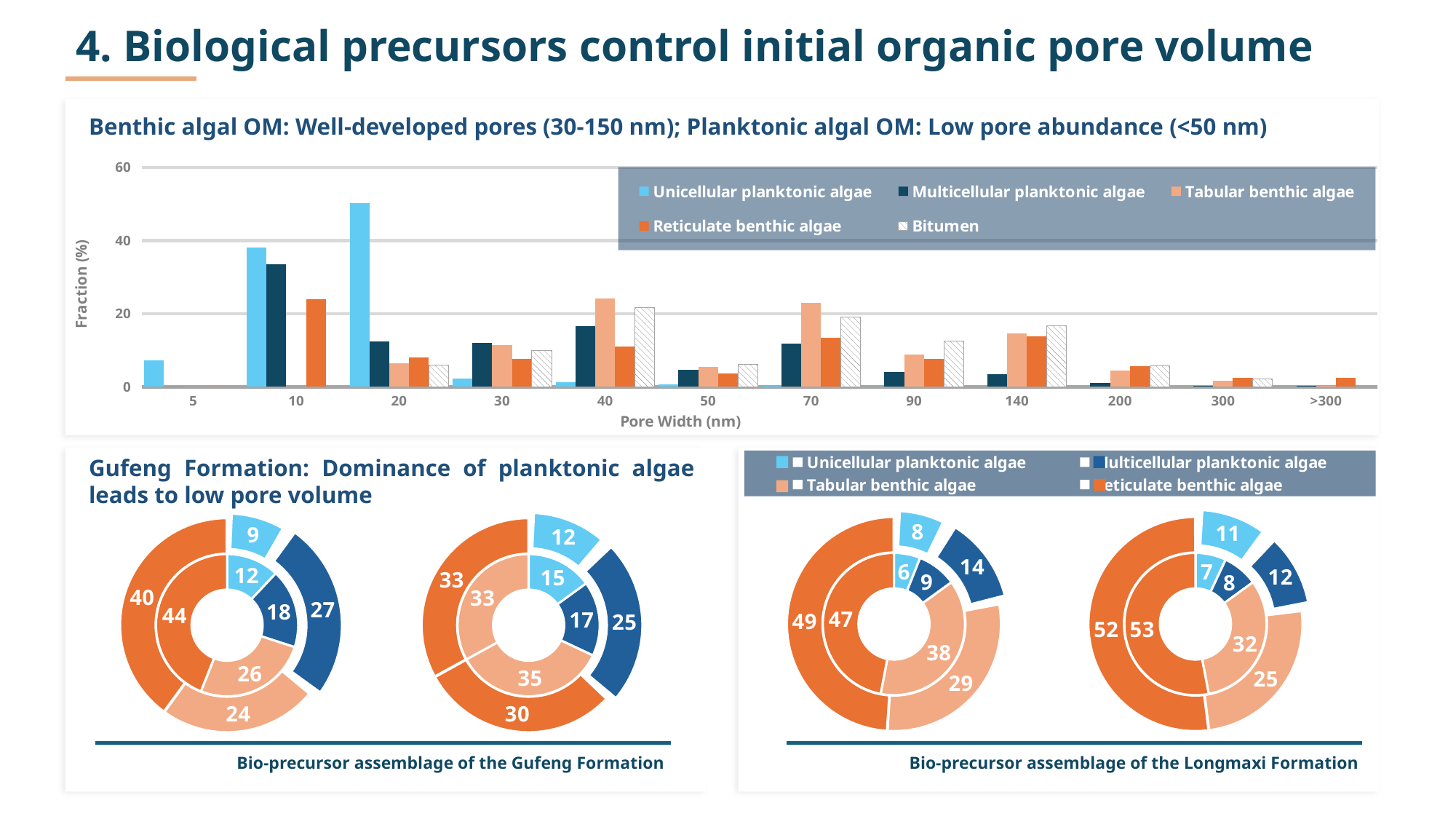
In the top bar chart, how many series does the legend list? 5 In the right donut chart of the Longmaxi Formation, which category has the largest outer-ring value? Reticulate benthic algae What kind of chart is the top chart titled 'Benthic algal OM: Well-developed pores (30-150 nm); Planktonic algal OM: Low pore abundance (<50 nm)'? Bar chart In the left donut chart of the Gufeng Formation, what is the outer-ring value for Reticulate benthic algae? 40 In the top bar chart, which series has the tallest bar overall? Unicellular planktonic algae In the top bar chart, how many pore width categories are shown on the x axis? 12 In the top bar chart, what is the label of the y axis? Fraction (%) In the top bar chart, is the value for Multicellular planktonic algae at 10 nm greater or less than 20? greater In the right donut chart of the Longmaxi Formation, what is the difference between the outer-ring values for Reticulate benthic algae (52) and Unicellular planktonic algae (11)? 41 In the top bar chart, is the value for Tabular benthic algae at 70 nm greater or less than 40? less In the left donut chart of the Longmaxi Formation, which outer-ring value is larger: Tabular benthic algae or Multicellular planktonic algae? Tabular benthic algae In the top bar chart, is the value for Unicellular planktonic algae at 20 nm greater or less than 40? greater